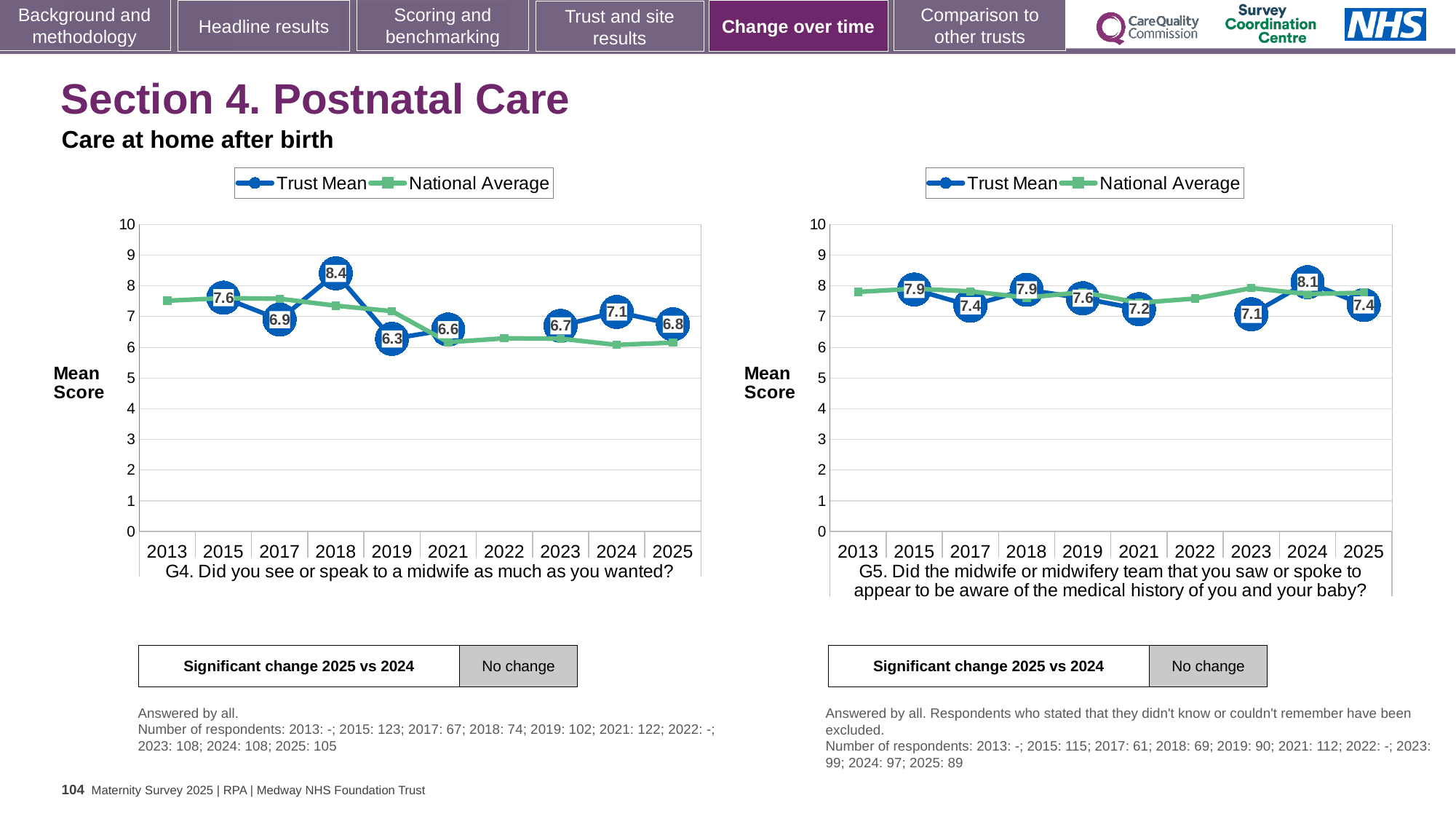
In the G5 chart on the right, which year has the highest Trust Mean score? 2024 How many years are shown on the x axis of the G4 chart on the left? 10 In the G4 chart on the left, what is the difference between the Trust Mean scores for 2018 and 2019? 2.1 In the G4 chart on the left, is the Trust Mean score higher in 2024 or in 2025? 2024 In the G4 chart on the left, which year has the lowest Trust Mean score? 2019 In the G5 chart on the right, what is the Trust Mean score for 2024? 8.1 How many series does the legend of the G5 chart on the right list? 2 In the G5 chart on the right, what is the difference between the Trust Mean scores for 2024 and 2025? 0.7 In the G5 chart on the right, is the National Average value for 2013 greater or less than 7? greater In the G4 chart on the left, what is the Trust Mean score for 2018? 8.4 What kind of chart is the G4 chart on the left? Line chart In the G4 chart on the left, what is the Trust Mean score for 2025? 6.8